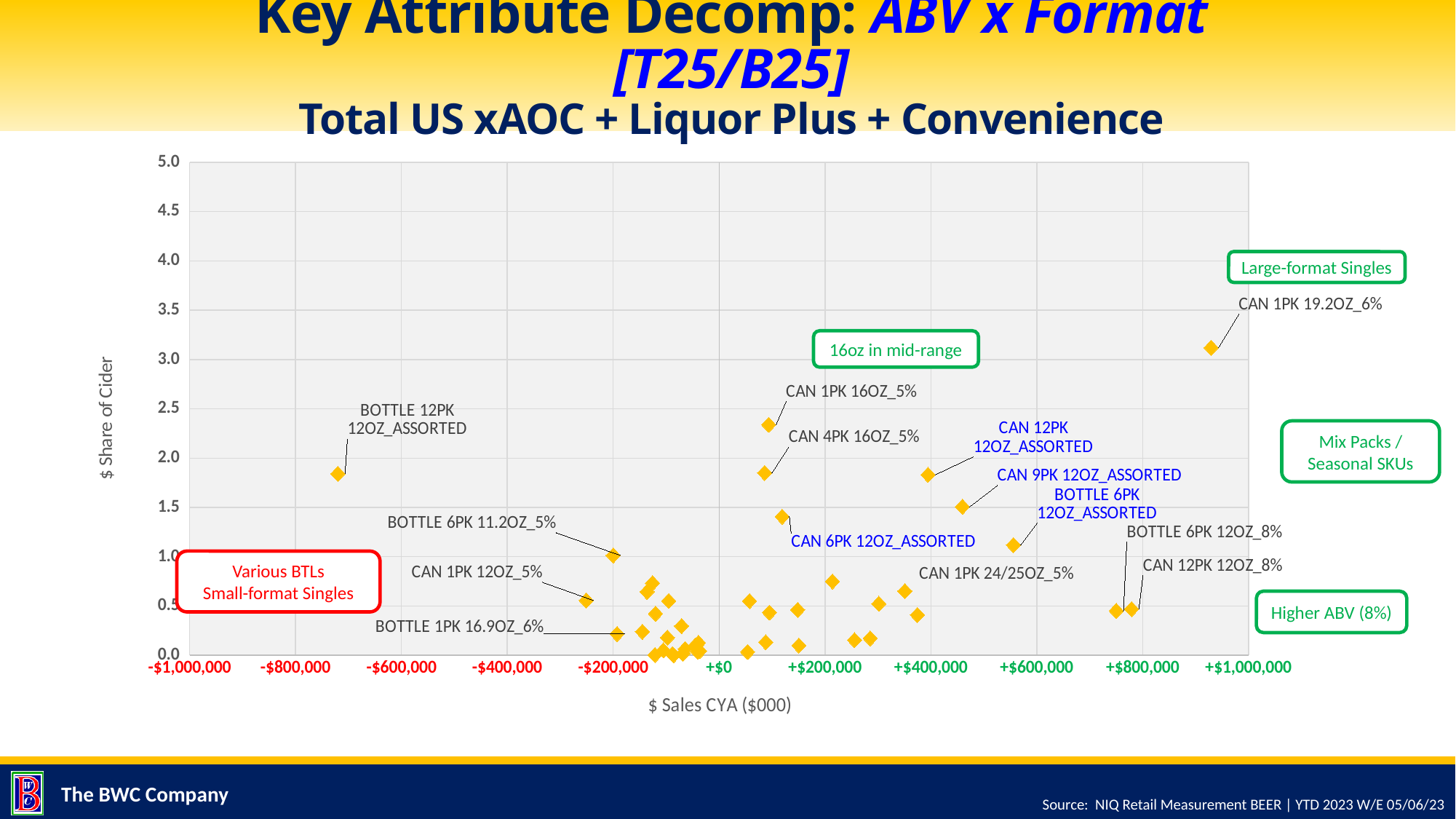
What kind of chart is shown on the slide? Scatter chart What is the title of the vertical axis of the chart? $ Share of Cider Which labelled point has the lowest (most negative) $ Sales CYA? BOTTLE 12PK 12OZ_ASSORTED Which has the higher $ Share of Cider, BOTTLE 6PK 11.2OZ_5% or CAN 1PK 12OZ_5%? BOTTLE 6PK 11.2OZ_5% Is the $ Sales CYA for BOTTLE 12PK 12OZ_ASSORTED greater or less than -$600,000? less Which labelled point has the highest $ Share of Cider? CAN 1PK 19.2OZ_6% Which has the higher $ Share of Cider, CAN 12PK 12OZ_ASSORTED or CAN 9PK 12OZ_ASSORTED? CAN 12PK 12OZ_ASSORTED Is the $ Share of Cider for CAN 1PK 16OZ_5% greater or less than 2.0? greater Which has the higher $ Share of Cider, CAN 1PK 16OZ_5% or CAN 4PK 16OZ_5%? CAN 1PK 16OZ_5% Which labelled point has the highest $ Sales CYA? CAN 1PK 19.2OZ_6% Is the $ Share of Cider for BOTTLE 6PK 12OZ_8% greater or less than 1.0? less